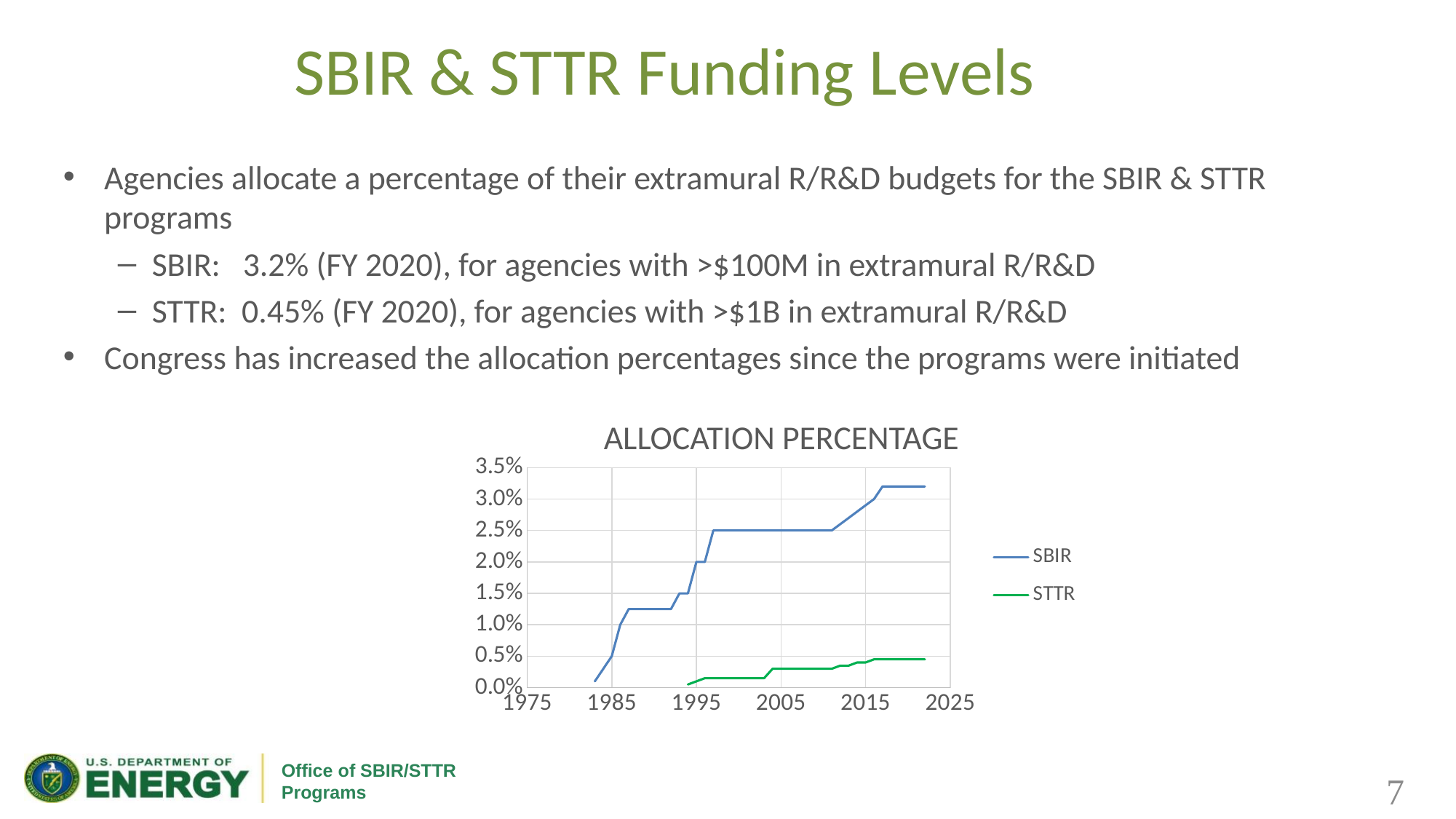
Is the STTR value in 2015 greater or less than 0.5%? less What kind of chart is shown on the slide? line chart What is the SBIR allocation percentage in 2005? 2.5% Is the SBIR value in 2005 greater or less than 2.0%? greater Does the SBIR allocation percentage rise or fall over time along the x axis? rise Which series reaches the highest allocation percentage in the chart? SBIR Is the STTR value in 2005 greater or less than 0.5%? less Which series has the higher value in 2015, SBIR or STTR? SBIR How many series does the chart legend list? 2 What is the title of the chart? ALLOCATION PERCENTAGE Which series is drawn in green in the chart? STTR